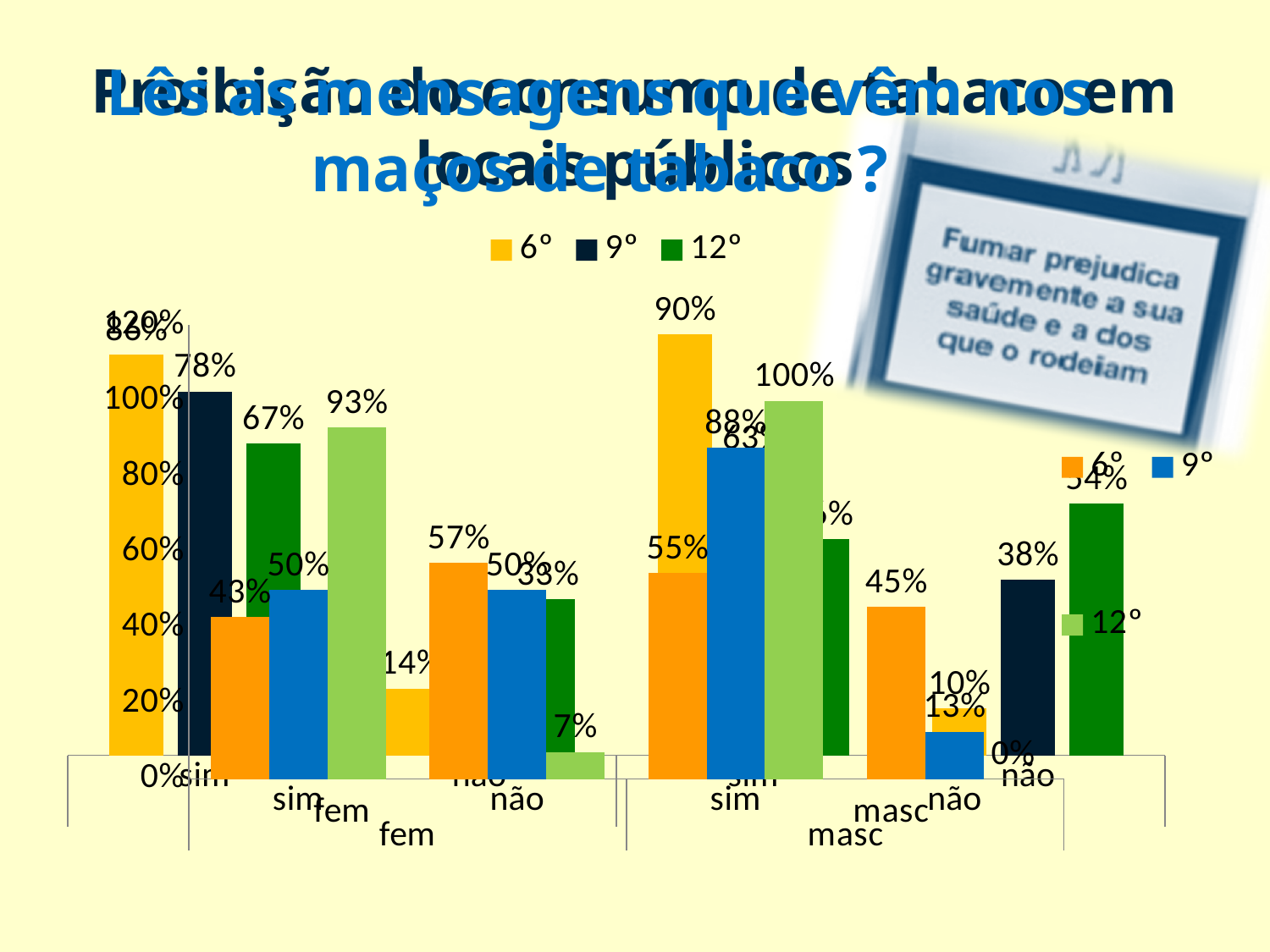
In the chart whose legend shows 12° in light green, what is the value of the light green 12° bar for 'fem sim'? 93% In the chart whose legend shows 12° in light green, what is the value of the light green 12° bar for 'masc sim'? 100% For the light green 12° series, which is larger: the value for 'fem sim' or the value for 'fem não'? fem sim In the chart whose legend shows 6° in yellow, what is the value of the yellow 6° bar for 'masc sim'? 90% What kind of chart is shown on the slide? bar chart In the chart whose legend shows 12° in light green, what is the value of the light green 12° bar for 'fem não'? 7% In the chart whose legend shows 6° in orange, what is the value of the orange 6° bar for 'fem não'? 57% What are the series names listed in the legend at the top of the chart? 6°, 9°, 12° In the chart whose legend shows 6° in orange, what is the value of the orange 6° bar for 'masc não'? 45% How many series does the legend at the top of the chart list? 3 Among the light green 12° bars, which category has the highest value? masc sim For the light green 12° series, what is the difference between the value for 'fem sim' (93%) and the value for 'fem não' (7%)? 86 percentage points